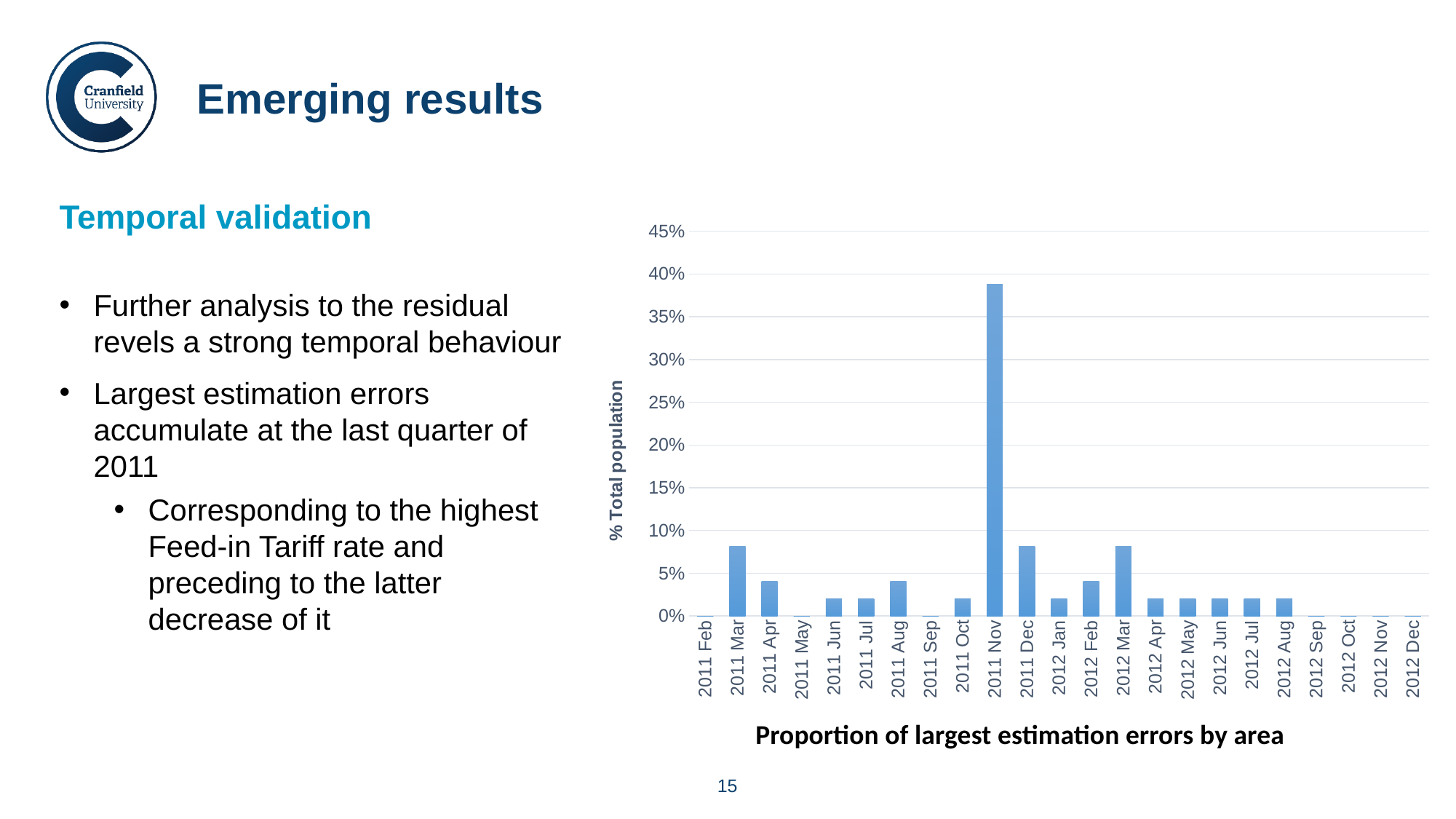
How many months are shown on the x axis of the chart? 23 What is the title of the chart? Proportion of largest estimation errors by area Which is larger, the value for 2011 Mar or the value for 2011 Apr? 2011 Mar Which is larger, the value for 2012 Mar or the value for 2012 Jun? 2012 Mar Is the value for 2011 Dec greater or less than 5%? greater Is the value for 2012 Apr greater or less than 5%? less Which month has the highest proportion of largest estimation errors? 2011 Nov Is the value for 2011 Nov greater or less than 35%? greater Which is larger, the value for 2011 Nov or the value for 2011 Dec? 2011 Nov What is the label on the y axis of the chart? % Total population What kind of chart is shown on the slide? Bar chart